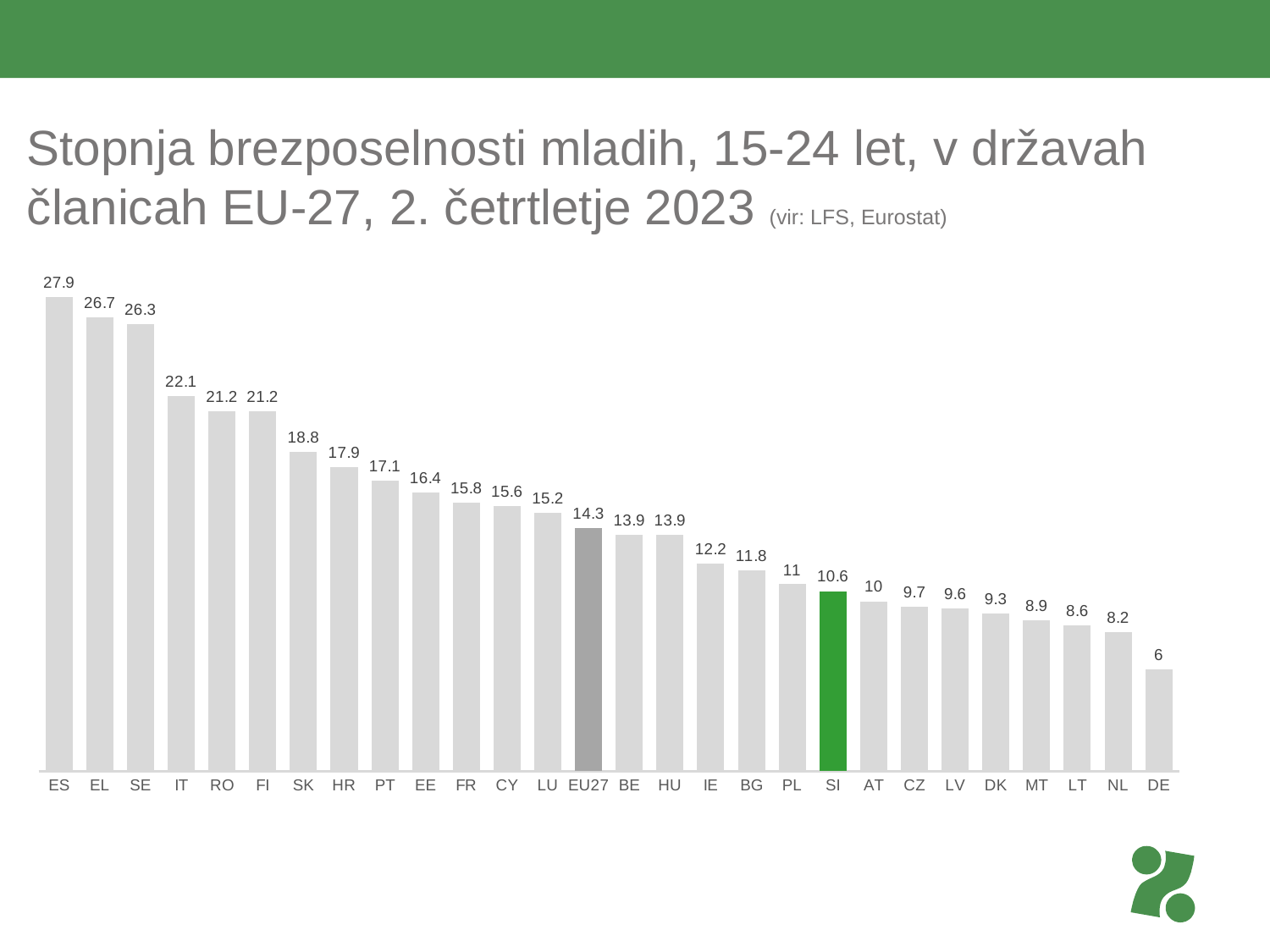
What is the difference between the values for EU27 and SI? 3.7 Which country has the lowest youth unemployment rate on the chart? DE Which has a higher value, IT or HR? IT How many bars (categories) are shown on the chart? 28 Which bar is highlighted in green on the chart? SI What type of chart is shown on the slide? bar chart What is the youth unemployment rate shown for SI? 10.6 What is the value shown for SK? 18.8 What is the difference between the values for ES and DE? 21.9 Which country has the highest youth unemployment rate on the chart? ES What is the value shown for EU27? 14.3 Do the values rise or fall from left to right along the x axis? fall